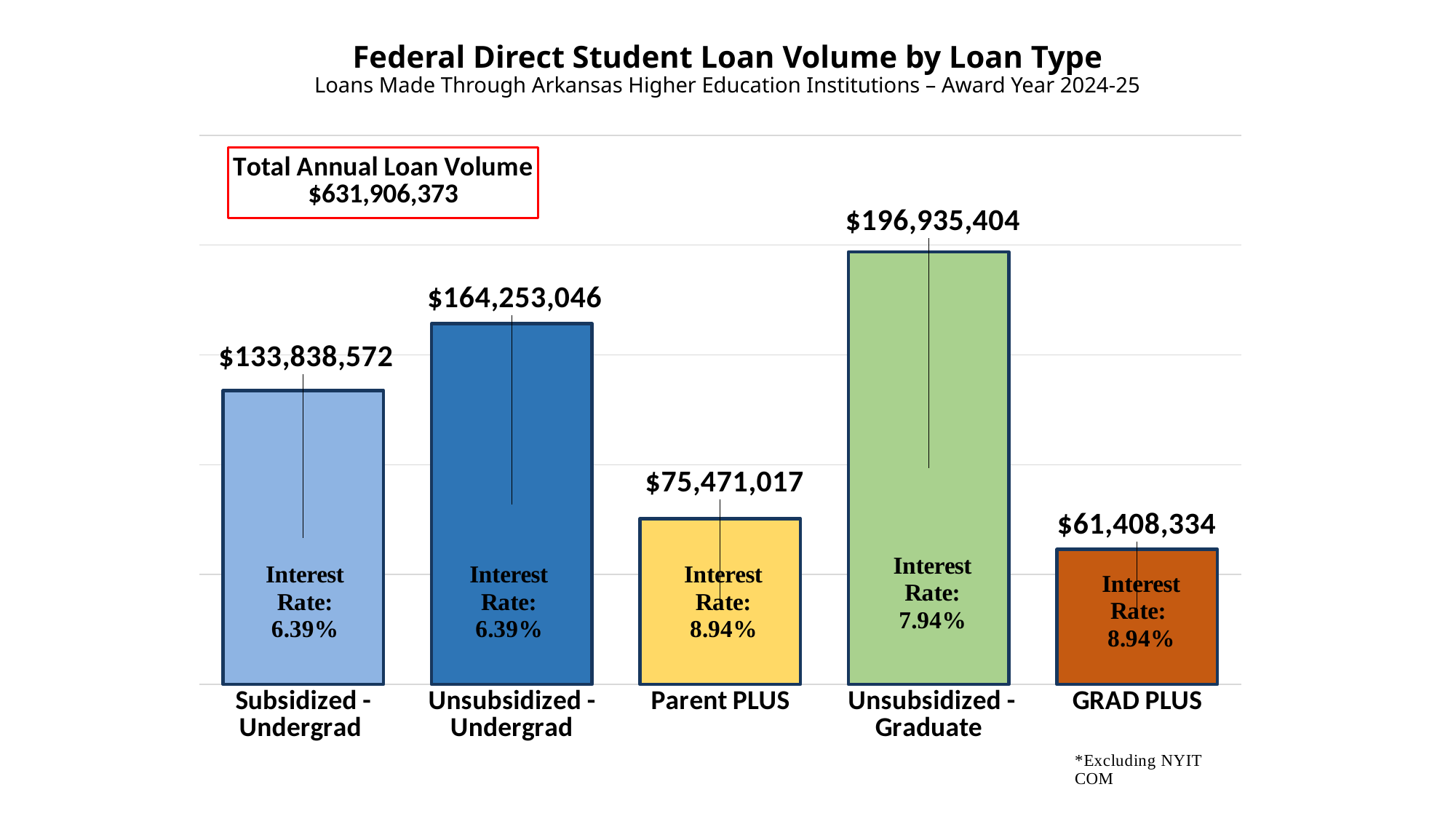
Which loan type has the highest loan volume? Unsubsidized - Graduate What is the loan volume for Unsubsidized - Graduate? $196,935,404 What is the Total Annual Loan Volume shown in the red box? $631,906,373 Which has a larger loan volume, Subsidized - Undergrad or Unsubsidized - Undergrad? Unsubsidized - Undergrad What interest rate is shown for GRAD PLUS? 8.94% What is the loan volume for Parent PLUS? $75,471,017 How many loan types are shown in the chart? 5 What kind of chart is shown on the slide? Bar chart What interest rate is shown for Unsubsidized - Graduate? 7.94% What is the difference in loan volume between Parent PLUS and GRAD PLUS? $14,062,683 What is the difference in loan volume between Unsubsidized - Graduate and Unsubsidized - Undergrad? $32,682,358 Which loan type has the lowest loan volume? GRAD PLUS